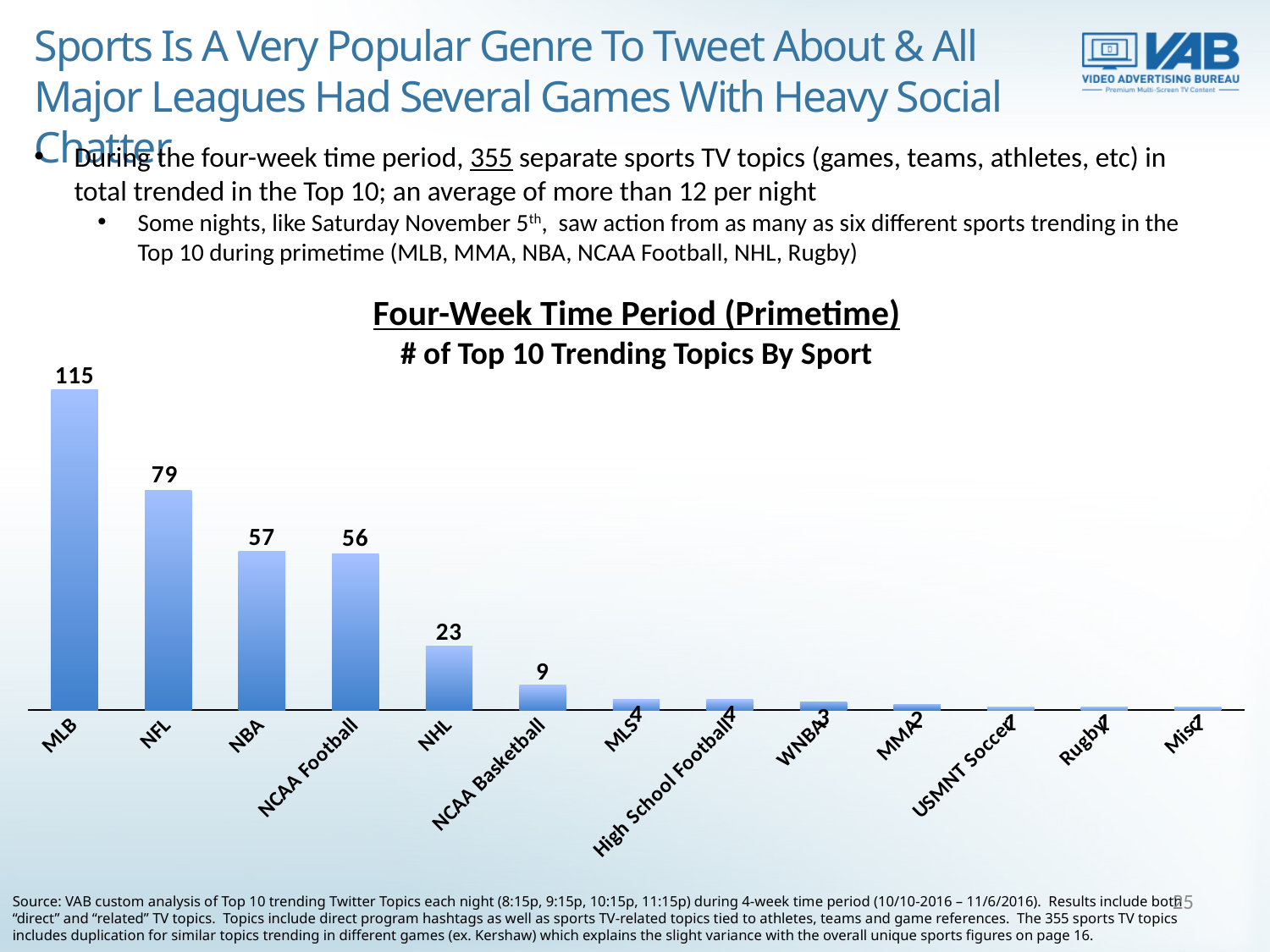
Which is larger, the value for NBA or the value for NHL? NBA What is the subtitle of the chart below 'Four-Week Time Period (Primetime)'? # of Top 10 Trending Topics By Sport Which sport has the highest number of Top 10 trending topics? MLB What is the value for NCAA Football? 56 What is the difference between the values for NBA and NHL? 34 What is the value for MLB? 115 What is the difference between the values for MLB and NFL? 36 How many sport categories are shown on the chart? 13 What is the value for NHL? 23 What is the value for NFL? 79 What is the value for NCAA Basketball? 9 What kind of chart is shown on the slide? Bar chart